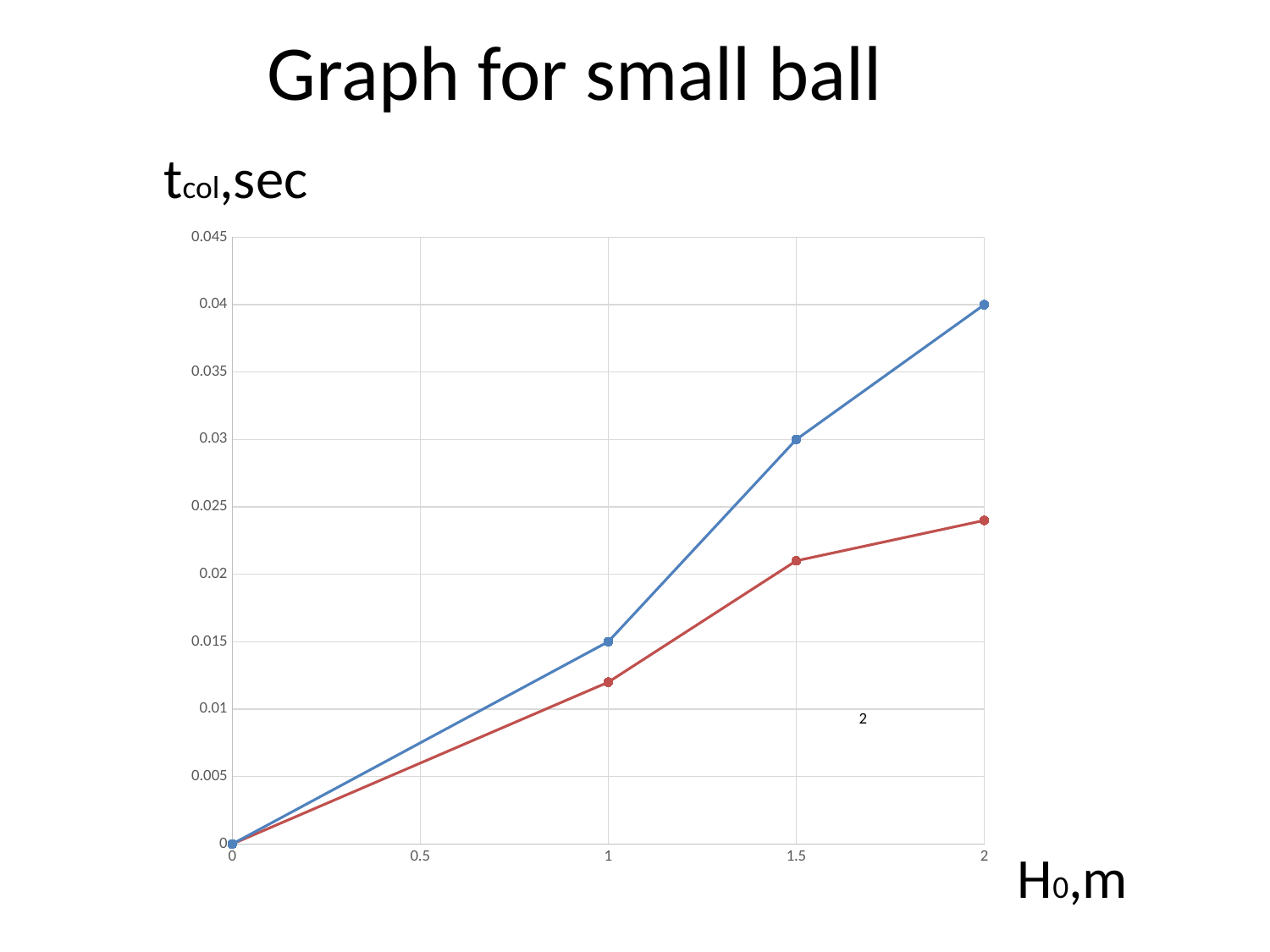
How many lines are plotted on the chart? 2 How many data points are plotted on the blue line? 4 What is the value of the blue line at H0 = 2 m? 0.04 What kind of chart is shown on the slide? line chart Is the value of the red line at H0 = 1 m greater or less than 0.01? greater What is the difference between the blue line's value at H0 = 2 m and at H0 = 1 m? 0.025 Is the value of the red line at H0 = 1.5 m greater or less than 0.02? greater What is the value of the blue line at H0 = 1.5 m? 0.03 Is the value of the red line at H0 = 2 m greater or less than 0.025? less At H0 = 2 m, which line has the larger value, the blue line or the red line? blue line Does the blue line rise or fall as H0 increases? rises What is the value of the blue line at H0 = 1 m? 0.015